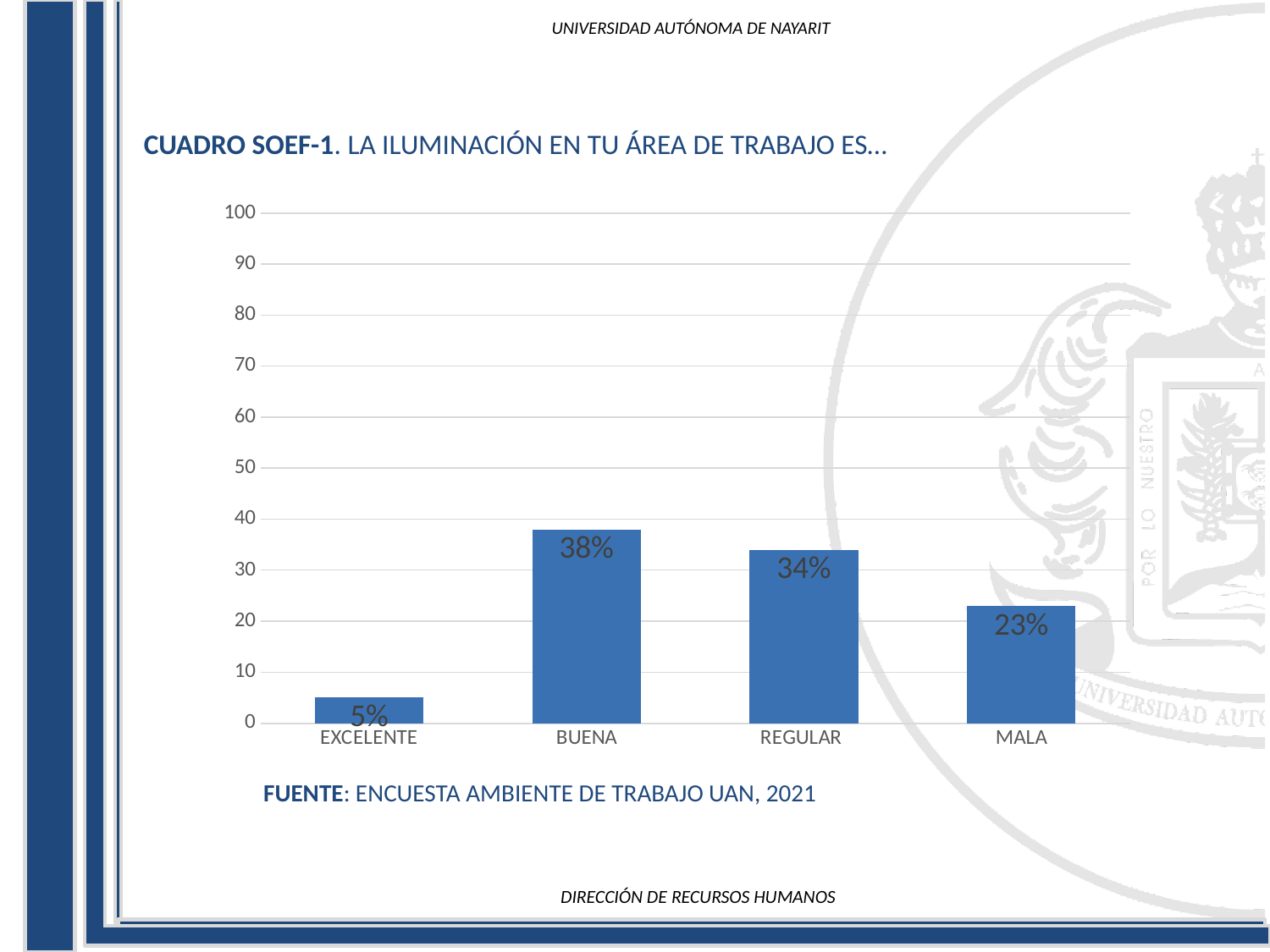
How many categories are shown on the x axis? 4 What kind of chart is shown on the slide? bar chart What is the value for BUENA? 38% What is the difference between the values for BUENA and REGULAR? 4% Which category has the highest value? BUENA Which is larger, the value for MALA or the value for EXCELENTE? MALA Is the value for BUENA greater or less than 30? greater What is the value for REGULAR? 34% What is the value for MALA? 23% What is the value for EXCELENTE? 5% Which category has the lowest value? EXCELENTE What is the difference between the values for REGULAR and MALA? 11%